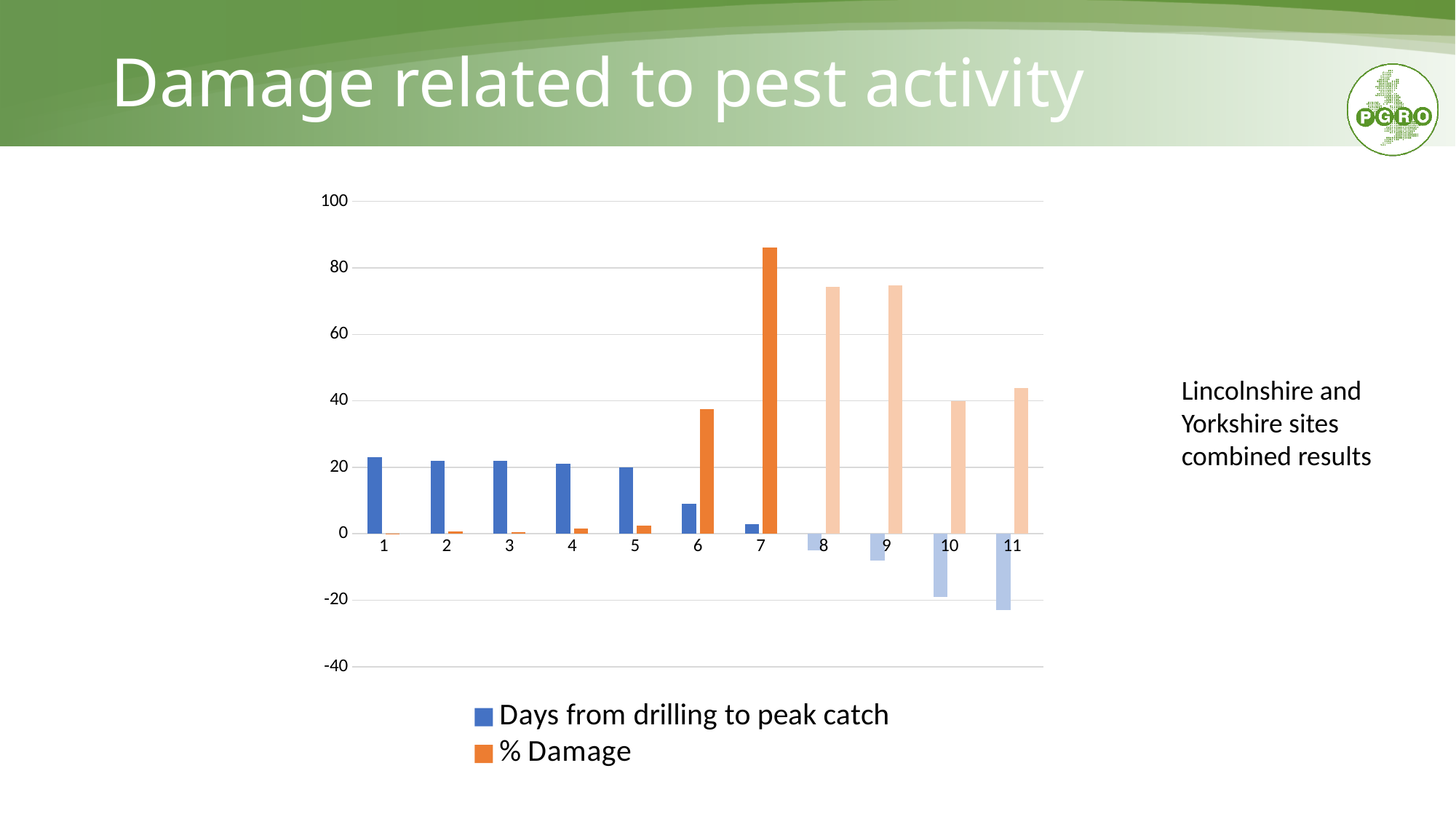
Which category has the highest % Damage value? 7 What kind of chart is shown on the slide? bar chart Which category has the lowest value for Days from drilling to peak catch? 11 Which has the larger % Damage value, category 7 or category 8? 7 How many series does the legend list? 2 Do the Days from drilling to peak catch values rise or fall from category 1 to category 11? fall How many categories are shown along the x axis? 11 Is the % Damage value for category 7 greater or less than 80? greater Which has the larger Days from drilling to peak catch value, category 5 or category 6? 5 Is the % Damage value for category 8 greater or less than 60? greater Is the Days from drilling to peak catch value for category 11 greater or less than -20? less